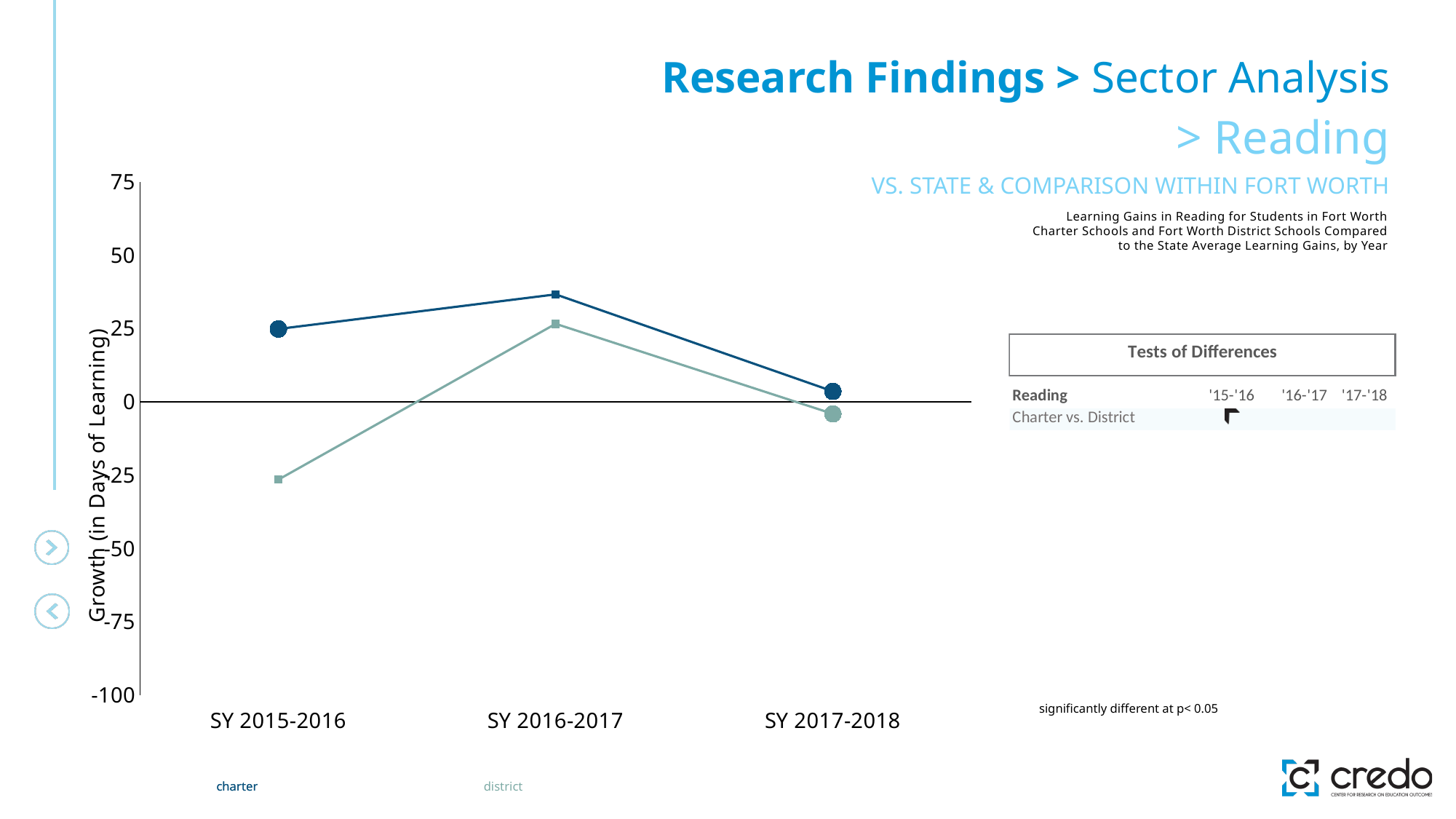
In which school year does the district series reach its lowest value? SY 2015-2016 In which school year does the charter series reach its lowest value? SY 2017-2018 Is the value for charter in SY 2016-2017 greater or less than 25? greater Does the district series rise or fall from SY 2015-2016 to SY 2016-2017? rise In SY 2015-2016, which series has the larger value, charter or district? charter How many school years are plotted on the x axis? 3 What is the label of the y axis? Growth (in Days of Learning) In which school year does the charter series reach its highest value? SY 2016-2017 Which two series are listed in the legend? charter and district Is the value for district in SY 2015-2016 greater or less than 0? less What kind of chart is shown on the slide? line chart How many series does the legend list? 2